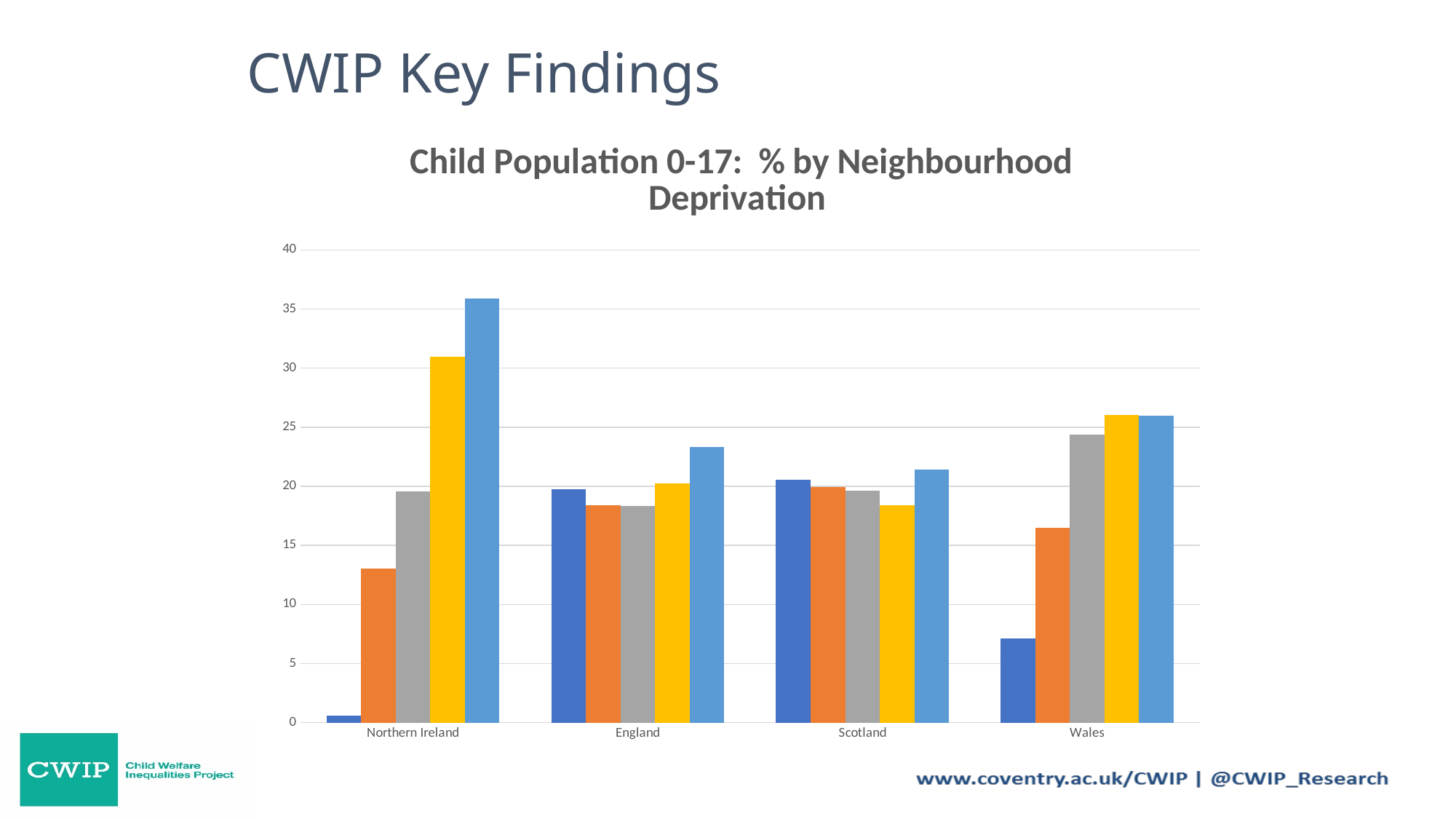
Which is larger: the dark blue bar for Northern Ireland or the dark blue bar for Wales? Wales Which country contains the tallest bar in the chart? Northern Ireland Is the value of the light blue bar for England greater or less than 20? greater Is the value of the dark blue bar for Wales greater or less than 10? less Is the value of the orange bar for Northern Ireland greater or less than 15? less How many countries are shown on the x axis of the chart? 4 Which is larger: the light blue bar for England or the light blue bar for Scotland? England Which country contains the shortest bar in the chart? Northern Ireland What is the title of the chart? Child Population 0-17: % by Neighbourhood Deprivation How many bars are plotted for each country in the chart? 5 What kind of chart is shown on the slide? bar chart